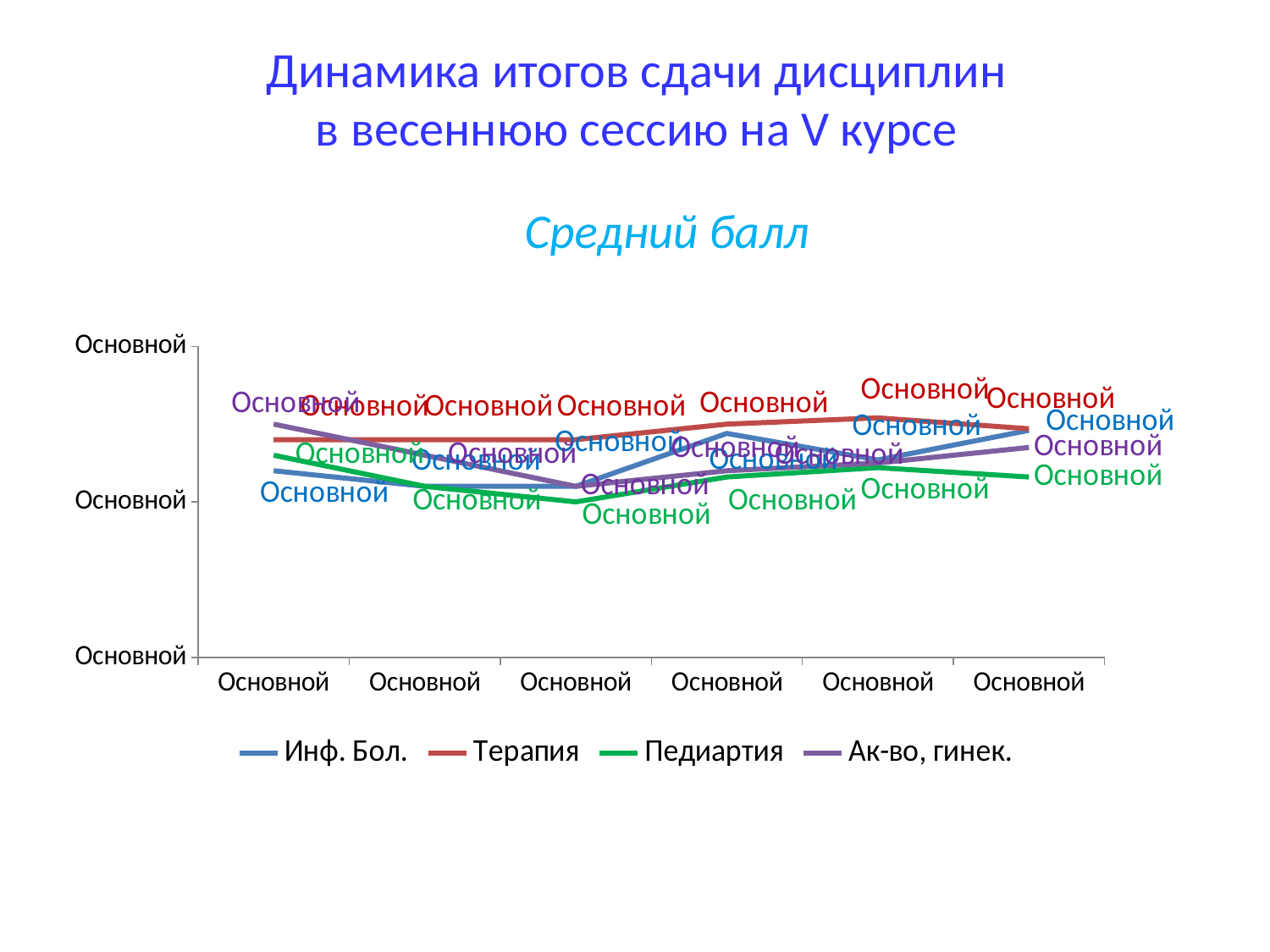
Which series has the highest values across the whole chart? Терапия How many series does the legend list? 4 What is the subtitle shown above the chart? Средний балл At the last point on the x axis, which is higher: Терапия or Педиартия? Терапия Which series is drawn in green? Педиартия What kind of chart is shown on the slide? line chart How many points along the x axis does each line have? 6 At the third point on the x axis, which is higher: Терапия or Инф. Бол.? Терапия